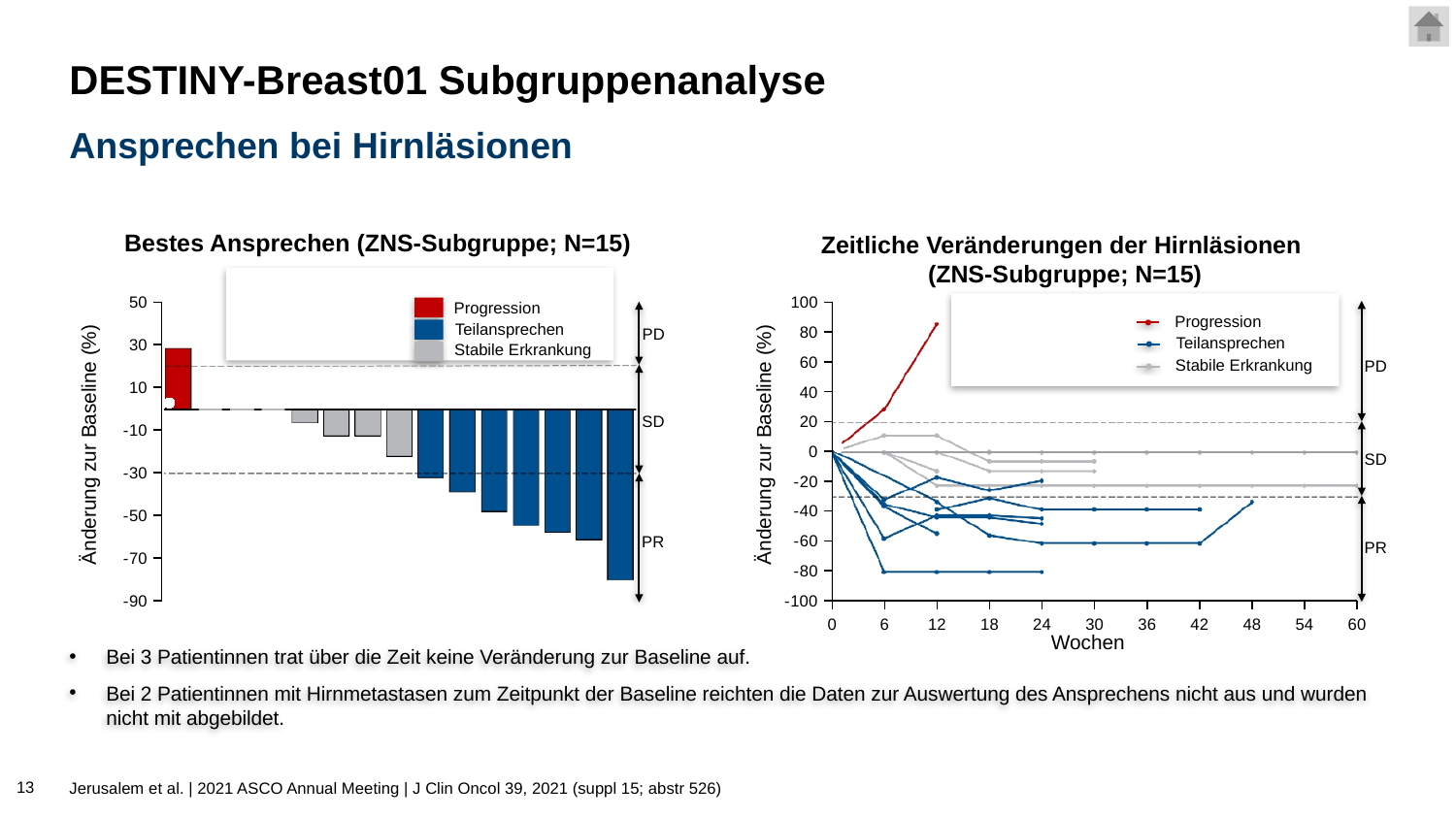
How many series does the legend of the left chart 'Bestes Ansprechen' list? 3 In the right chart 'Zeitliche Veränderungen der Hirnläsionen', does the red Progression line rise or fall over the weeks? rise What kind of chart is the left chart titled 'Bestes Ansprechen (ZNS-Subgruppe; N=15)'? bar chart In the left chart 'Bestes Ansprechen', which legend category does the lowest bar belong to? Teilansprechen In the left chart 'Bestes Ansprechen', how many bars are plotted? 12 In the left chart 'Bestes Ansprechen', is the value of the red Progression bar greater or less than 10? greater In the left chart 'Bestes Ansprechen', which colour represents 'Stabile Erkrankung' in the legend? grey How many entries does the legend of the right chart 'Zeitliche Veränderungen der Hirnläsionen' list? 3 What is the x-axis label of the right chart 'Zeitliche Veränderungen der Hirnläsionen'? Wochen What kind of chart is the right chart titled 'Zeitliche Veränderungen der Hirnläsionen (ZNS-Subgruppe; N=15)'? line chart In the right chart 'Zeitliche Veränderungen der Hirnläsionen', is the last value of the red Progression line greater or less than 60? greater In the left chart 'Bestes Ansprechen', is the value of the lowest bar greater or less than -70? less